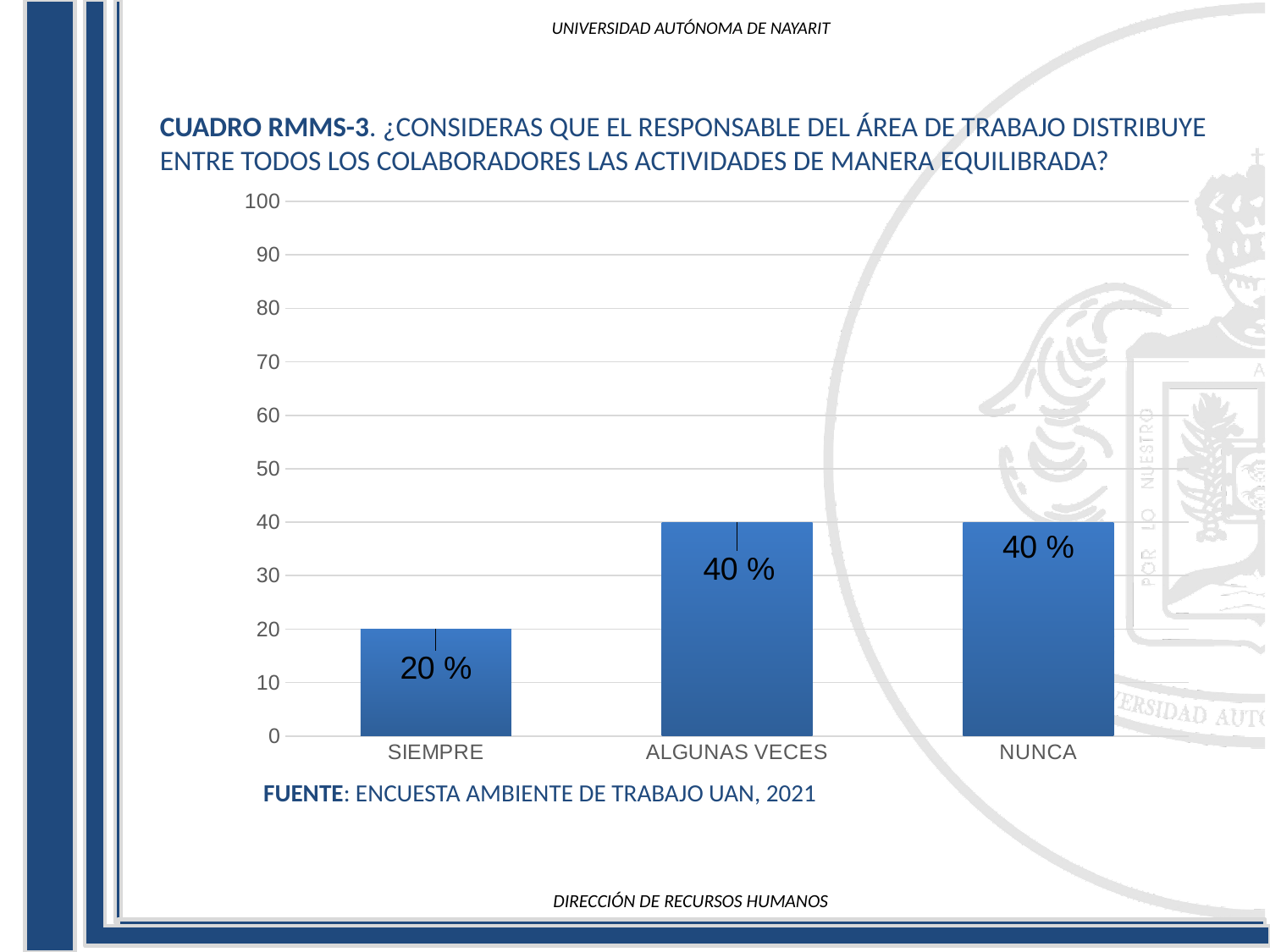
Which category has the lowest value? SIEMPRE What is the highest value shown on the y axis? 100 Is the value for SIEMPRE greater or less than 30? less What is the value for NUNCA? 40 % What is the value for ALGUNAS VECES? 40 % What source is cited below the chart? ENCUESTA AMBIENTE DE TRABAJO UAN, 2021 Is the value for ALGUNAS VECES greater or less than 30? greater What kind of chart is shown on the slide? bar chart What is the value for SIEMPRE? 20 % What is the difference between the values for ALGUNAS VECES and SIEMPRE? 20 % Which is larger, the value for SIEMPRE or the value for NUNCA? NUNCA How many categories are shown on the x axis? 3